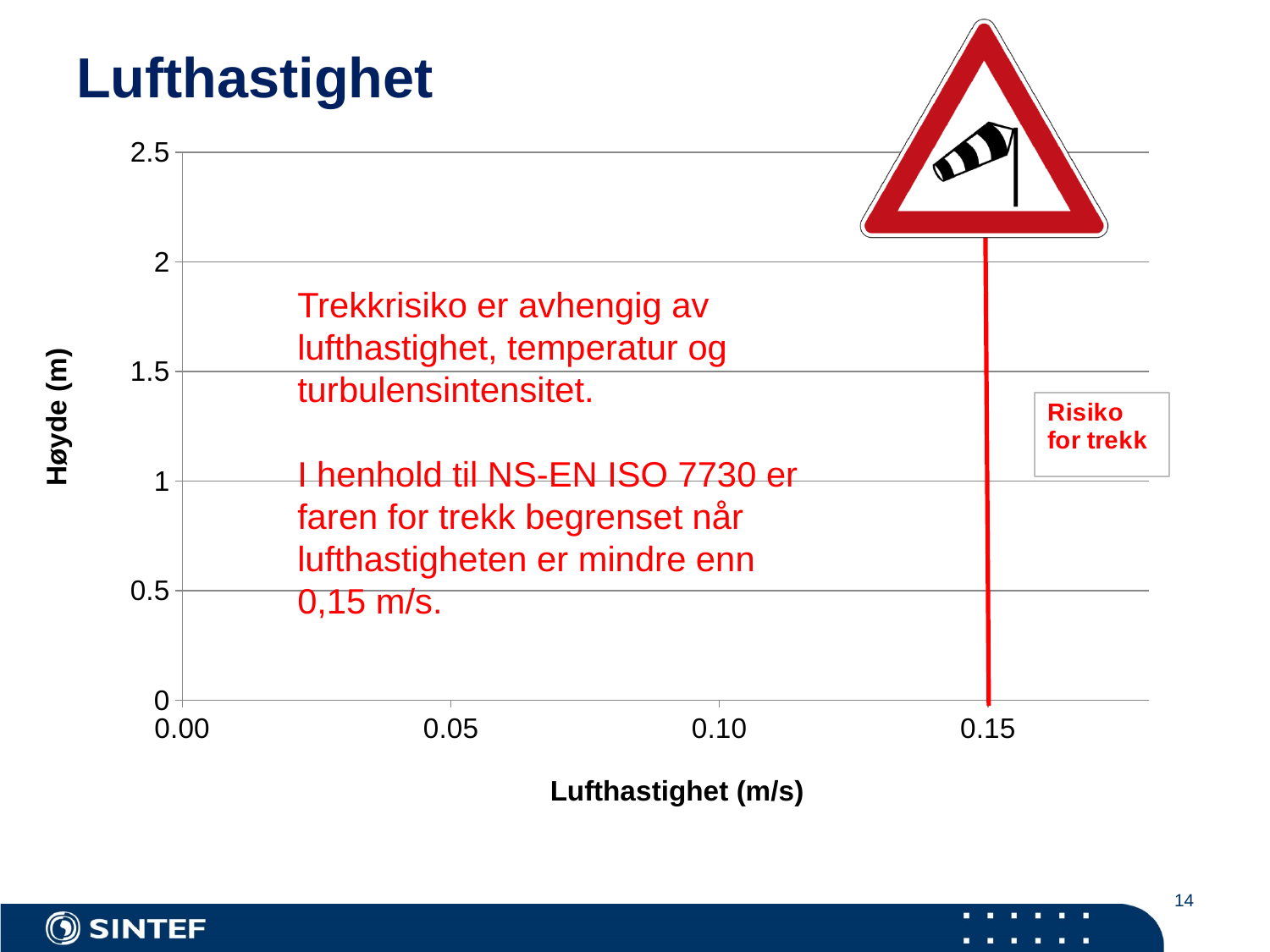
What label is attached to the vertical red line on the chart? Risiko for trekk Is the vertical red line positioned at an air speed greater or less than 0.10 m/s? greater What is the highest value shown on the x-axis of the chart? 0.15 What is the highest value shown on the y-axis (Høyde) of the chart? 2.5 What is the title of the y-axis on the chart? Høyde (m) At what air speed (Lufthastighet) is the vertical red line drawn on the chart? 0.15 What is the lowest value shown on the x-axis of the chart? 0.00